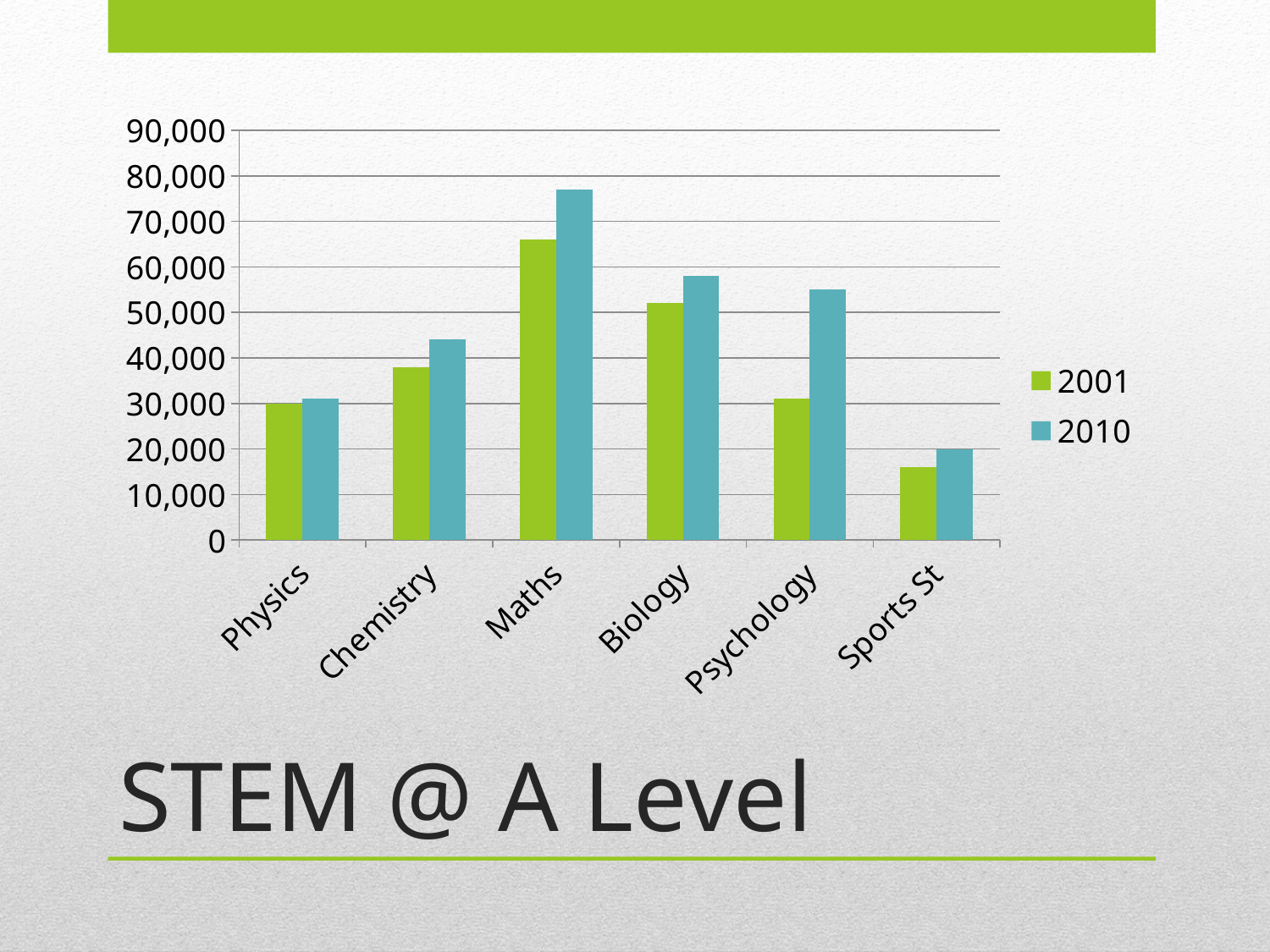
How many subject categories are shown on the x axis? 6 Is the 2001 value for Chemistry greater or less than 40,000? less Which subject has the highest value for 2001? Maths What are the two entries in the chart legend? 2001 and 2010 Which subject has the highest value for 2010? Maths Which is larger: the 2001 value for Maths or the 2010 value for Biology? Maths 2001 Is the 2001 value for Sports St greater or less than 20,000? less Which subject has the lowest value for 2001? Sports St What kind of chart is shown on the slide? bar chart Which is larger: the 2001 value for Chemistry or the 2001 value for Psychology? Chemistry How many series does the legend list? 2 Is the 2010 value for Maths greater or less than 70,000? greater